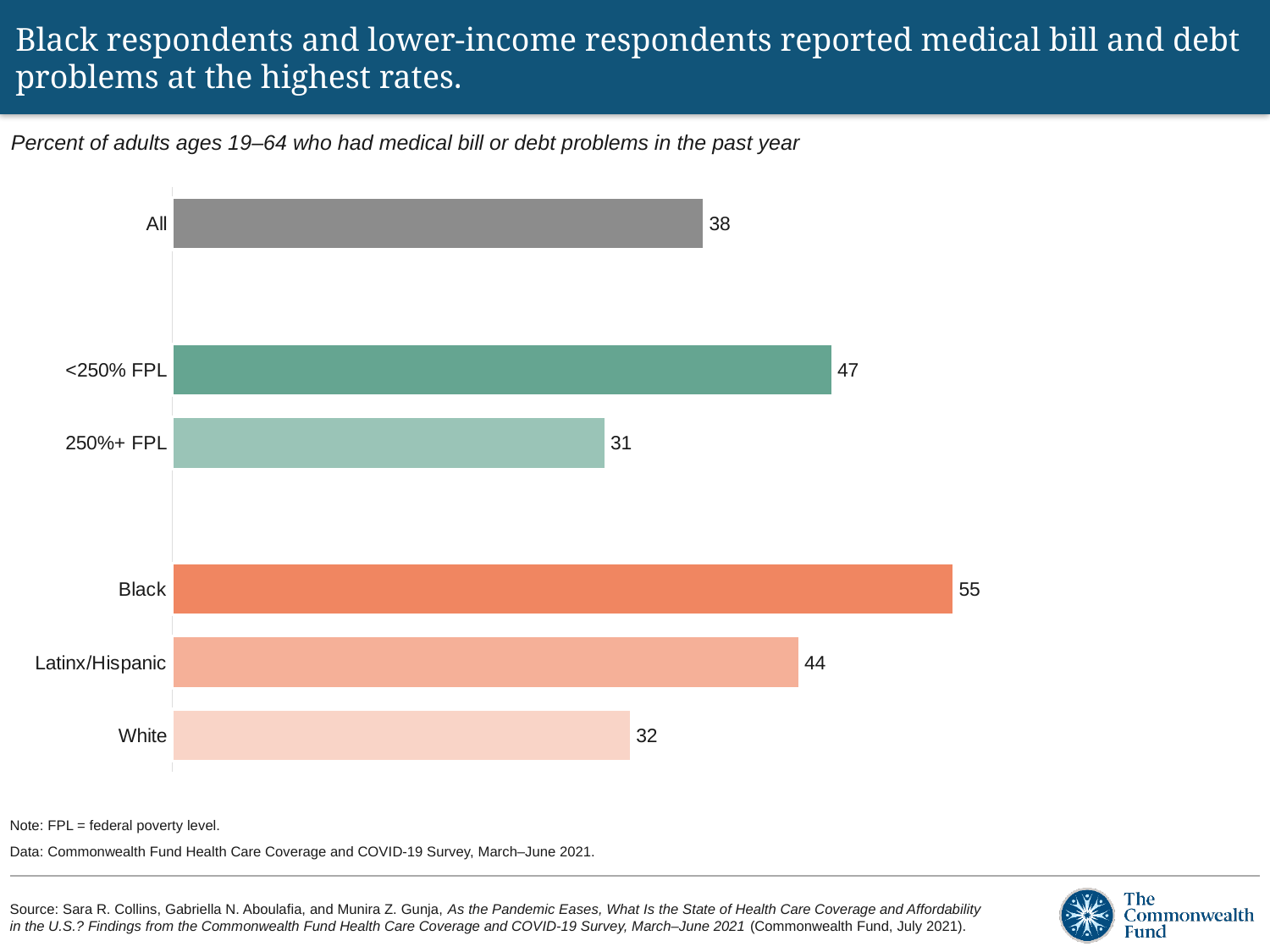
How many categories are shown in the chart? 6 What is the difference between the values for <250% FPL and 250%+ FPL? 16 Which is larger, the value for Latinx/Hispanic or the value for All? Latinx/Hispanic What is the difference between the values for Black and White respondents? 23 What does the note say FPL stands for? Federal poverty level Which category has the highest value? Black What kind of chart is shown on the slide? Bar chart What is the value for Latinx/Hispanic respondents? 44 What is the value for the All category? 38 Which category has the lowest value? 250%+ FPL What is the value for Black respondents? 55 What is the value for <250% FPL? 47